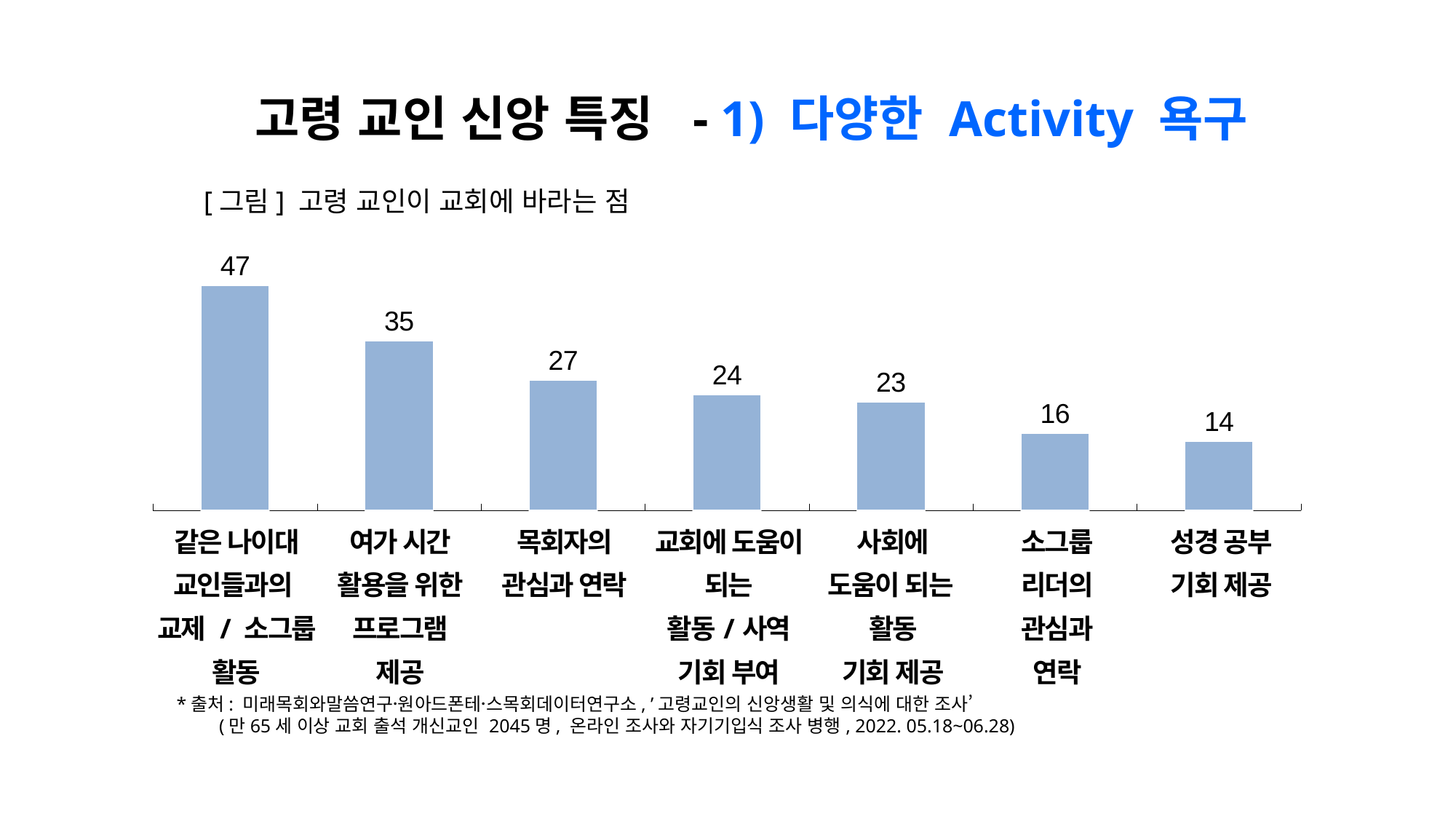
Which category has the lowest value? 성경 공부 기회 제공 What is the value for 목회자의 관심과 연락? 27 What is the difference between the values for 같은 나이대 교인들과의 교제 / 소그룹 활동 and 여가 시간 활용을 위한 프로그램 제공? 12 Which is larger: the value for 교회에 도움이 되는 활동 / 사역 기회 부여 or the value for 소그룹 리더의 관심과 연락? 교회에 도움이 되는 활동 / 사역 기회 부여 What is the value for 여가 시간 활용을 위한 프로그램 제공? 35 Do the values rise or fall from left to right across the categories? fall What is the value for 성경 공부 기회 제공? 14 What is the difference between the values for 소그룹 리더의 관심과 연락 and 성경 공부 기회 제공? 2 Which category has the highest value? 같은 나이대 교인들과의 교제 / 소그룹 활동 What kind of chart is shown on the slide? bar chart What is the caption of the chart shown on the slide? [ 그림 ] 고령 교인이 교회에 바라는 점 How many categories are shown in the chart? 7